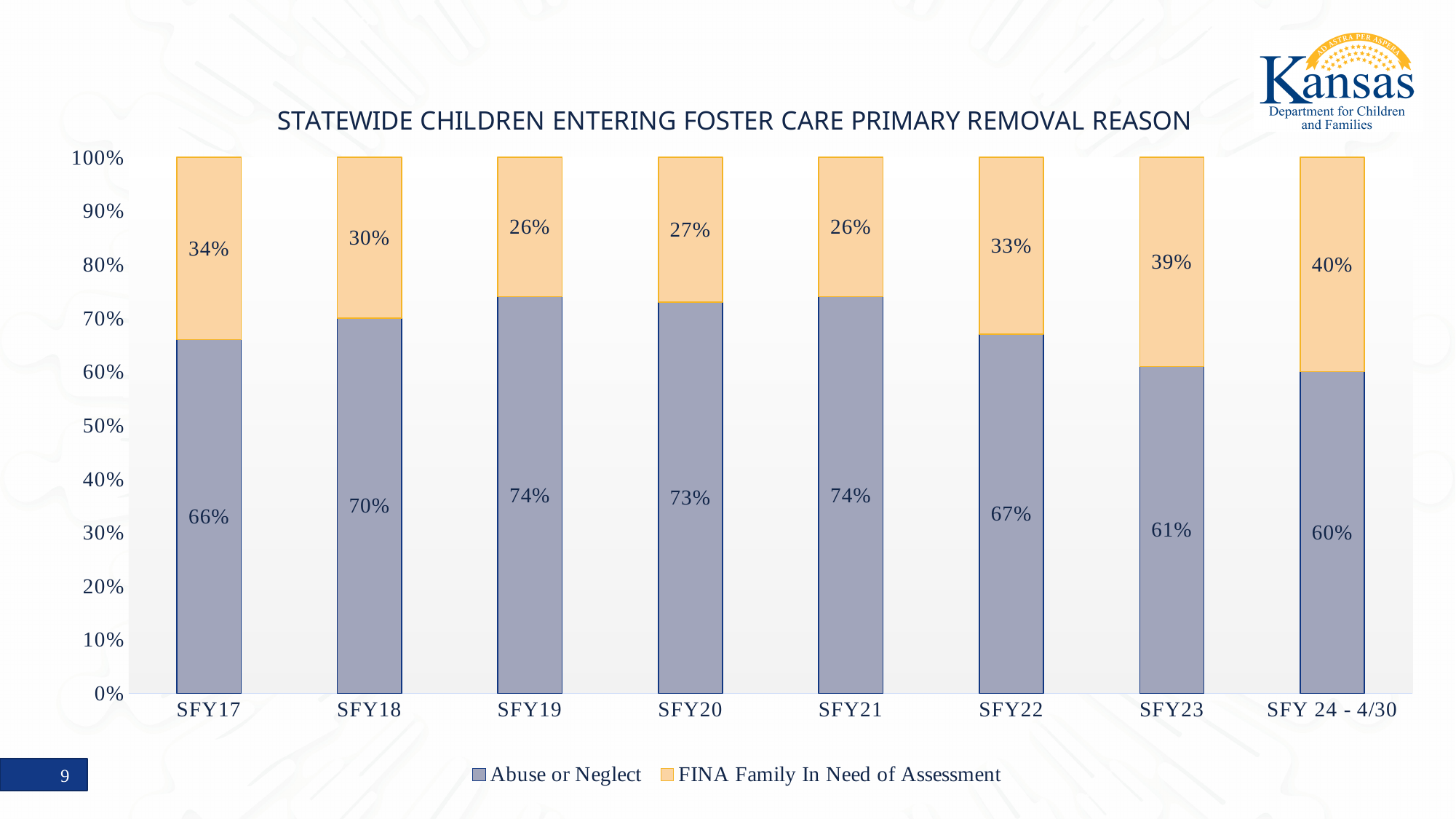
What is the total of the stacked bar for SFY20? 100% What is the Abuse or Neglect percentage for SFY22? 67% What is the title of the chart? STATEWIDE CHILDREN ENTERING FOSTER CARE PRIMARY REMOVAL REASON What is the difference between the Abuse or Neglect percentage for SFY17 and SFY23? 5% Which category has the highest FINA Family In Need of Assessment percentage? SFY 24 - 4/30 How many categories are shown on the x axis? 8 What is the FINA Family In Need of Assessment percentage for SFY 24 - 4/30? 40% Which is larger, the FINA percentage for SFY18 or for SFY22? SFY22 How many series does the legend list? 2 Which category has the lowest Abuse or Neglect percentage? SFY 24 - 4/30 What is the Abuse or Neglect percentage for SFY19? 74% What kind of chart is shown on the slide? Stacked bar chart